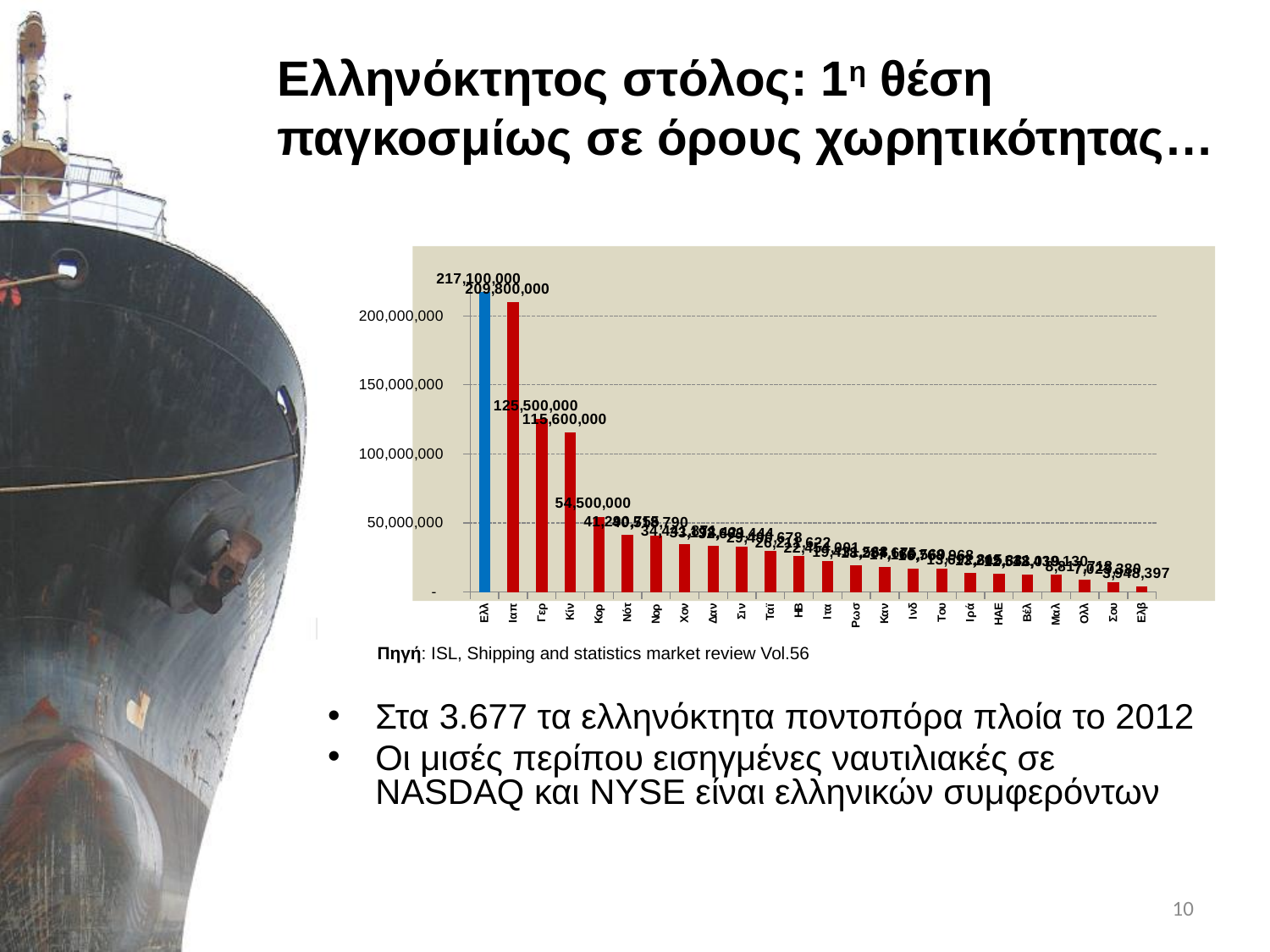
Is the value for Νότ greater or less than 50,000,000? less Which category has the highest value? Ελλ How many categories are shown on the x axis? 24 What is the value for Ιαπ? 209,800,000 Which category has the lowest value? Ελβ What is the value for Κίν? 115,600,000 What kind of chart is shown on the slide? bar chart What is the value for Κορ? 54,500,000 Which is larger, the value for Κίν or the value for Κορ? Κίν What is the value for Ελλ? 217,100,000 What is the value for Γερ? 125,500,000 What is the difference between the values for Ελλ and Ιαπ? 7,300,000